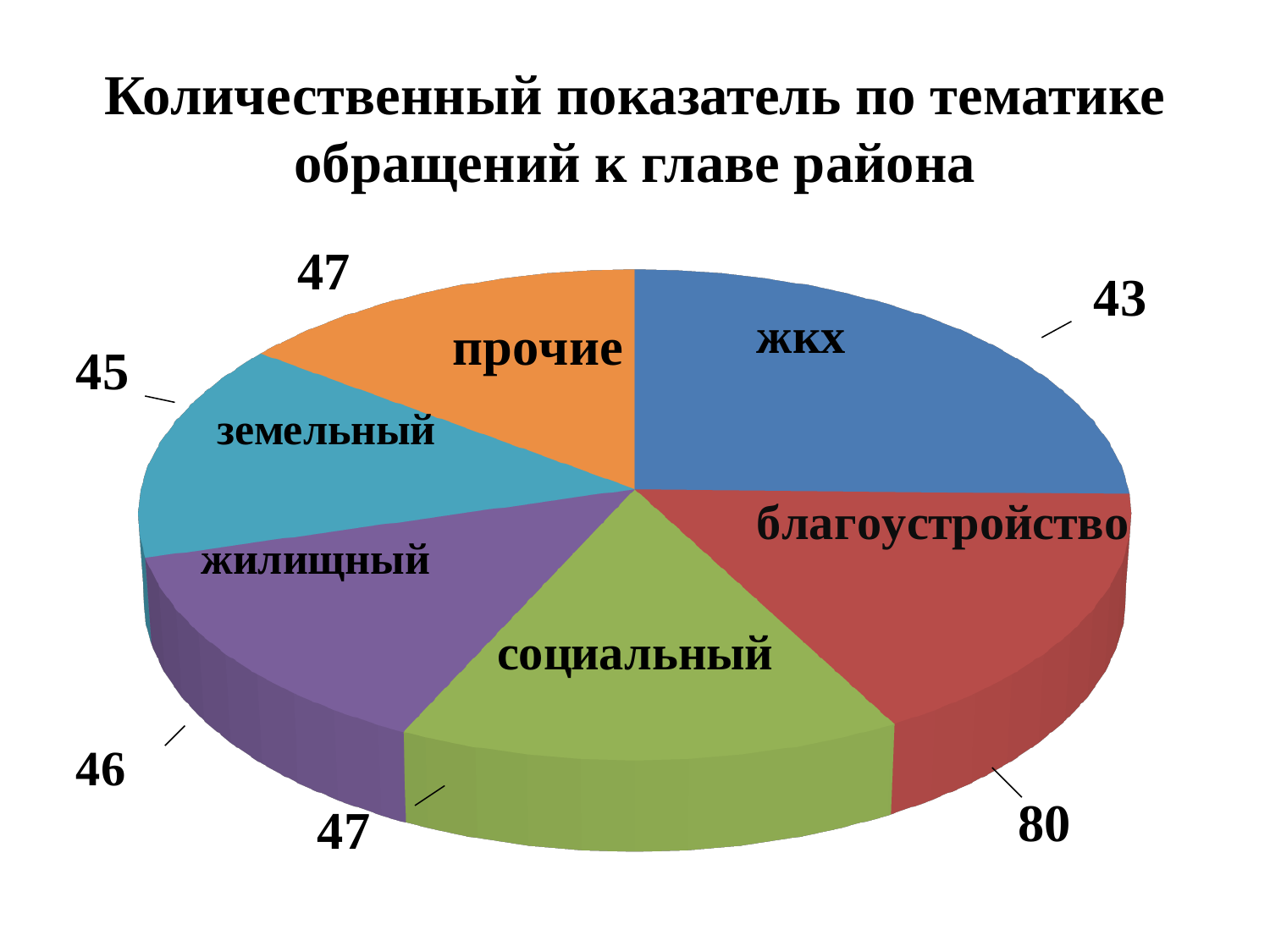
What is the value for жилищный? 46 What is the value for благоустройство? 80 What is the value for земельный? 45 What is the value for социальный? 47 Which is larger, the value for благоустройство or the value for социальный? благоустройство What kind of chart is shown on the slide? pie chart What is the difference between the values for благоустройство and жкх? 37 Which category has the lowest value? жкх What is the title of the chart? Количественный показатель по тематике обращений к главе района What is the value for жкх? 43 Which category has the highest value? благоустройство How many categories (slices) does the pie chart have? 6